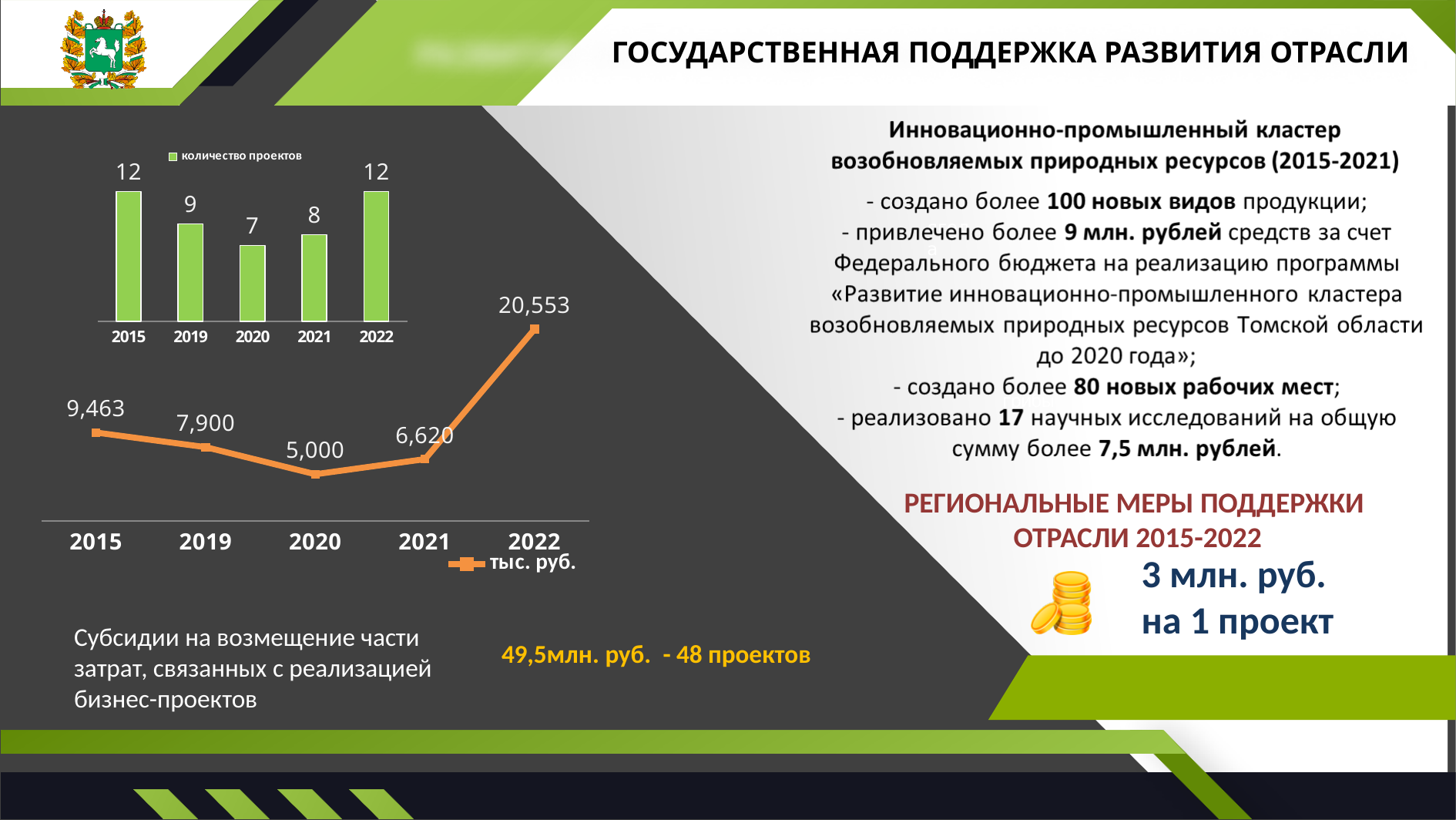
In the bar chart (количество проектов), what is the value for 2019? 9 In the bar chart (количество проектов), which year has the lowest value? 2020 What is the legend entry of the lower line chart? тыс. руб. In the bar chart (количество проектов), what is the difference between the values for 2015 and 2020? 5 In the line chart (тыс. руб.), which year has the highest value? 2022 What type of chart is the upper chart labelled количество проектов? bar chart In the line chart (тыс. руб.), what is the value for 2022? 20,553 In the line chart (тыс. руб.), what is the difference between the values for 2015 and 2019? 1,563 In the line chart (тыс. руб.), which is larger, the value for 2019 or the value for 2021? 2019 In the bar chart (количество проектов), how many years are shown on the x axis? 5 In the line chart (тыс. руб.), what is the value for 2020? 5,000 In the line chart (тыс. руб.), do the values rise or fall from 2015 to 2020? fall